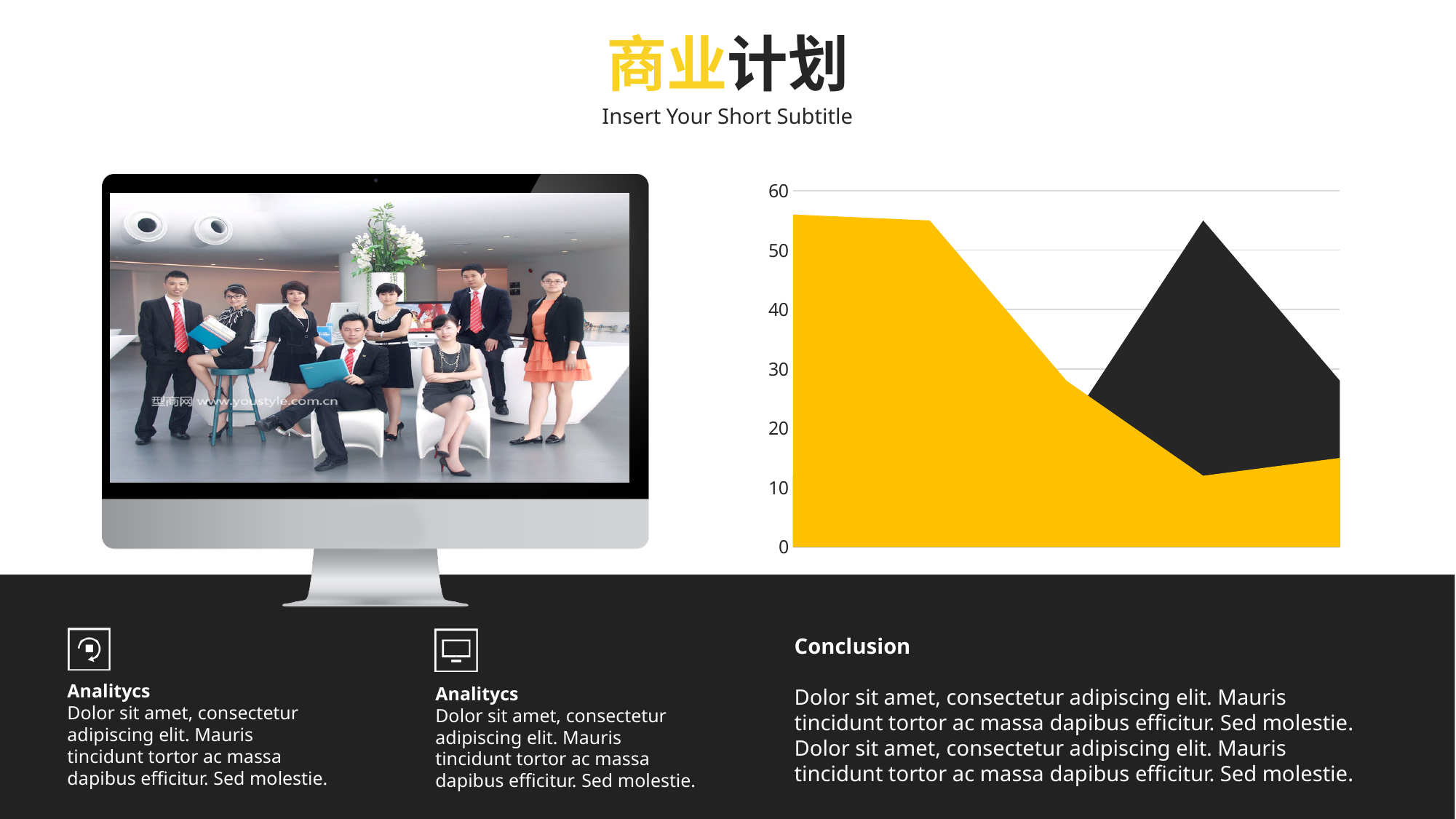
Is the leftmost value of the yellow series higher or lower than its rightmost value? higher Is the peak of the black series greater or less than 50? greater Is the lowest point of the yellow series greater or less than 20? less Does the yellow series generally rise or fall from left to right across the chart? fall Is the first (leftmost) value of the yellow series greater or less than 50? greater What kind of chart is shown on the right side of the slide? area chart What is the highest value shown on the chart's vertical axis? 60 What two colours are used for the series in the chart? yellow and black At the rightmost point of the chart, which series is higher, the black one or the yellow one? black